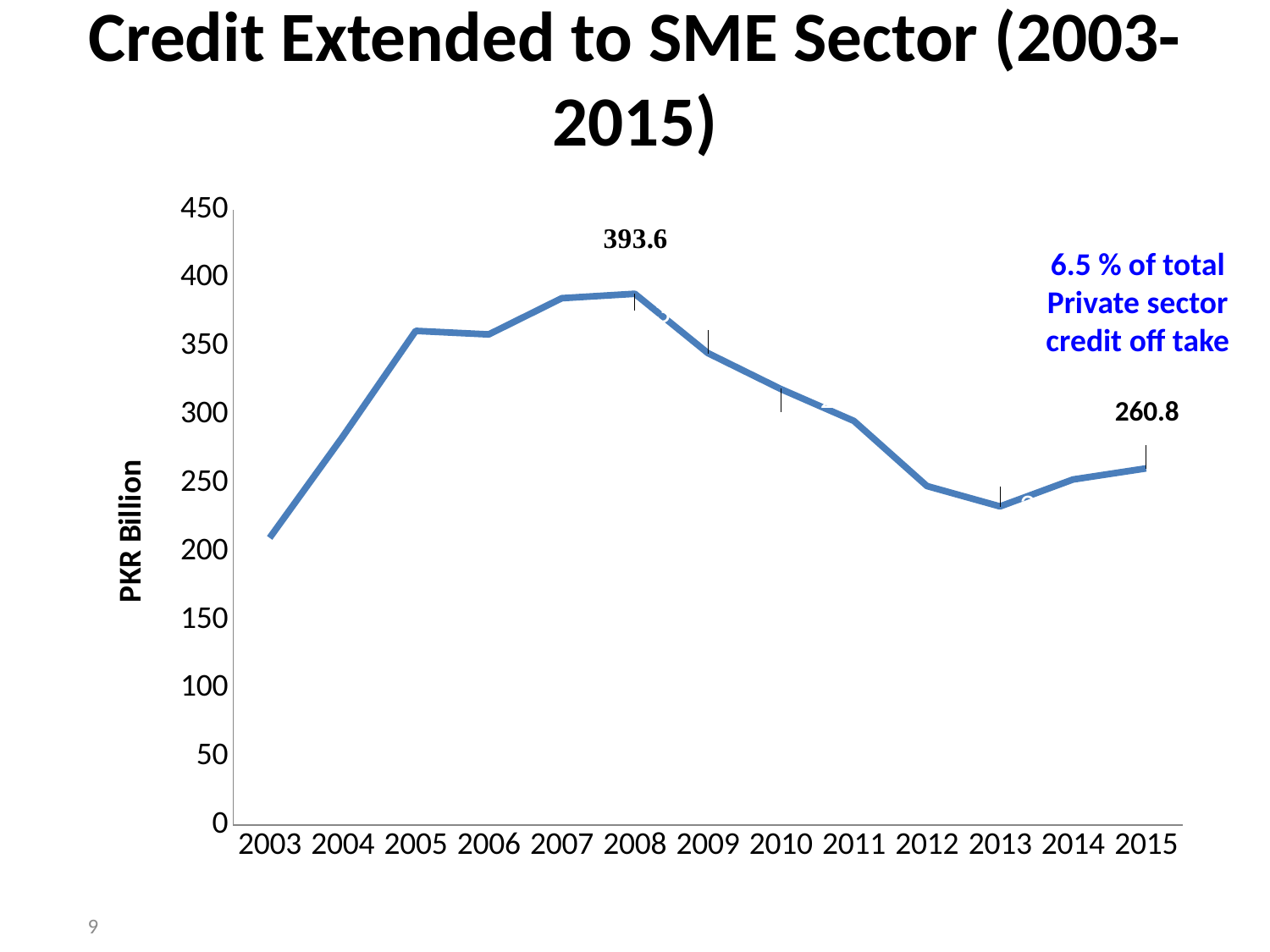
How many years are plotted on the x axis of the chart? 13 What kind of chart is shown on the slide? line chart In which year was credit extended to the SME sector lowest? 2003 In which year was credit extended to the SME sector highest? 2008 What is the value of credit extended to the SME sector in 2008? 393.6 By how much did credit extended to the SME sector fall from 2008 to 2015, in PKR billion? 132.8 Did credit extended to the SME sector rise or fall between 2008 and 2013? fall Is the value for 2003 greater or less than 250? less Which year had more credit extended to the SME sector, 2005 or 2011? 2005 Is the value for 2007 greater or less than 350? greater What is the value of credit extended to the SME sector in 2015? 260.8 What is the label on the vertical axis of the chart? PKR Billion